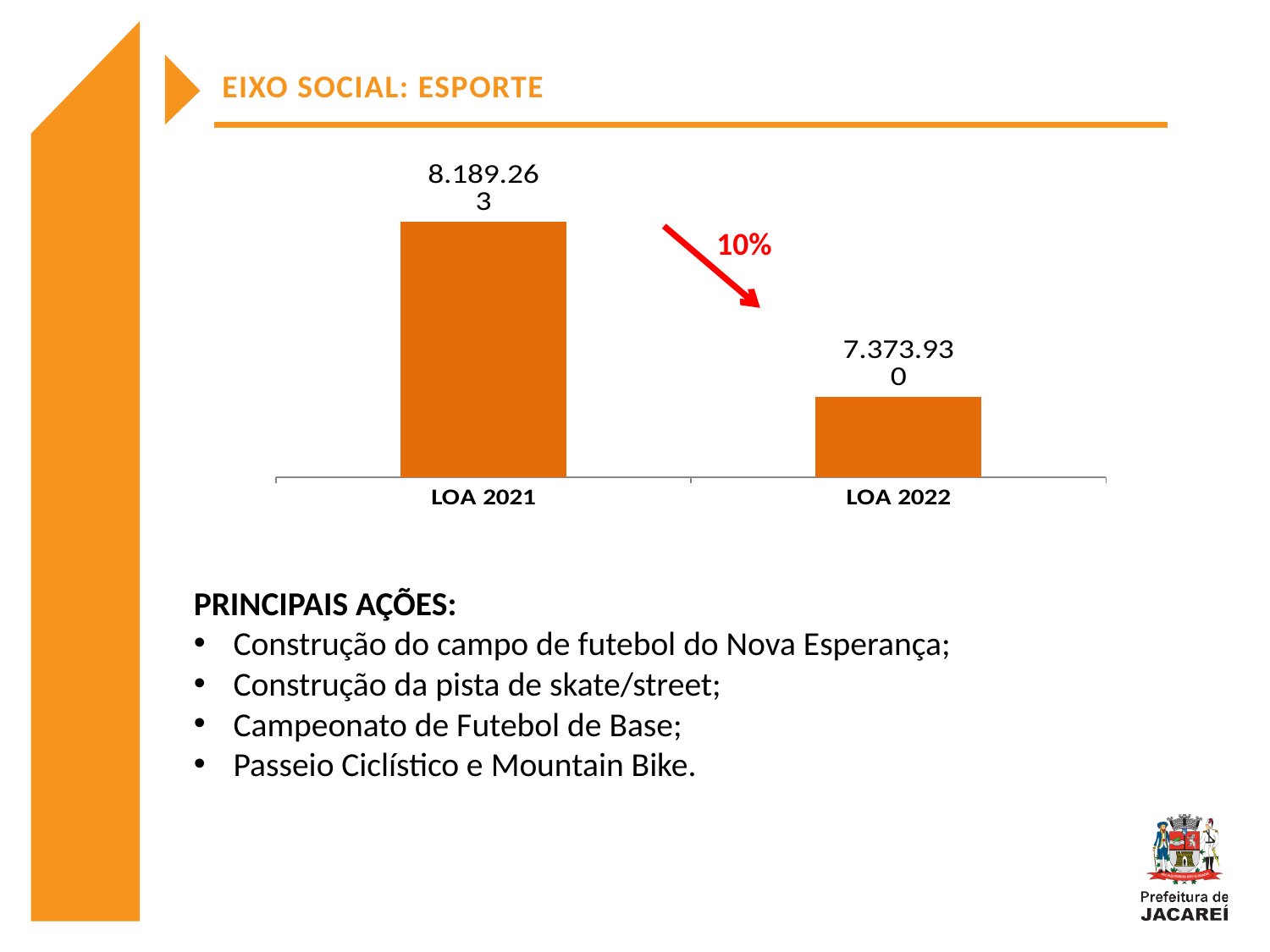
Which category has the highest value? LOA 2021 What percentage change is annotated next to the red arrow on the chart? 10% Which is larger, the value for LOA 2021 or the value for LOA 2022? LOA 2021 How many categories are shown on the chart? 2 Which category has the lowest value? LOA 2022 What kind of chart is shown on the slide? Bar chart What is the difference between the values for LOA 2021 and LOA 2022? 815.333 What colour are the bars in the chart? Orange What is the value for LOA 2022? 7.373.930 What is the value for LOA 2021? 8.189.263 Do the values rise or fall from LOA 2021 to LOA 2022? Fall